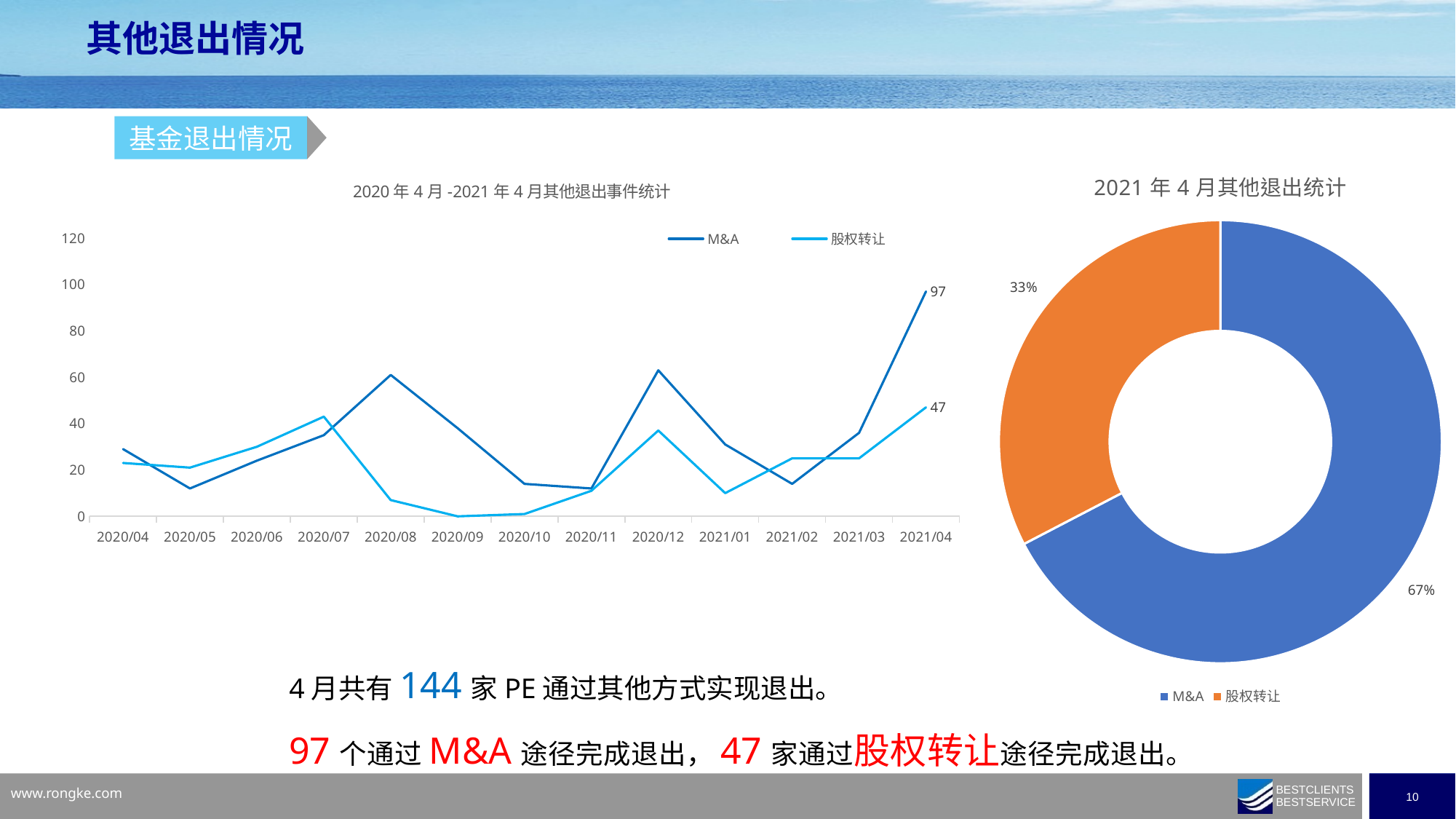
In the line chart 2020年4月-2021年4月其他退出事件统计, is the M&A value for 2020/08 greater or less than 40? greater In the pie chart 2021年4月其他退出统计, which category has the largest share? M&A In the line chart 2020年4月-2021年4月其他退出事件统计, what is the difference between the M&A and 股权转让 values for 2021/04? 50 How many months are shown on the x axis of the line chart 2020年4月-2021年4月其他退出事件统计? 13 In the line chart 2020年4月-2021年4月其他退出事件统计, at which month does the M&A series reach its highest value? 2021/04 What kind of chart is the chart titled 2021年4月其他退出统计? pie chart (doughnut) What kind of chart is the chart titled 2020年4月-2021年4月其他退出事件统计? line chart In the line chart 2020年4月-2021年4月其他退出事件统计, what is the M&A value for 2021/04? 97 In the line chart 2020年4月-2021年4月其他退出事件统计, is the 股权转让 value for 2020/09 greater or less than 20? less How many series does the legend of the line chart 2020年4月-2021年4月其他退出事件统计 list? 2 In the pie chart 2021年4月其他退出统计, what share does M&A have? 67% In the line chart 2020年4月-2021年4月其他退出事件统计, what is the 股权转让 value for 2021/04? 47